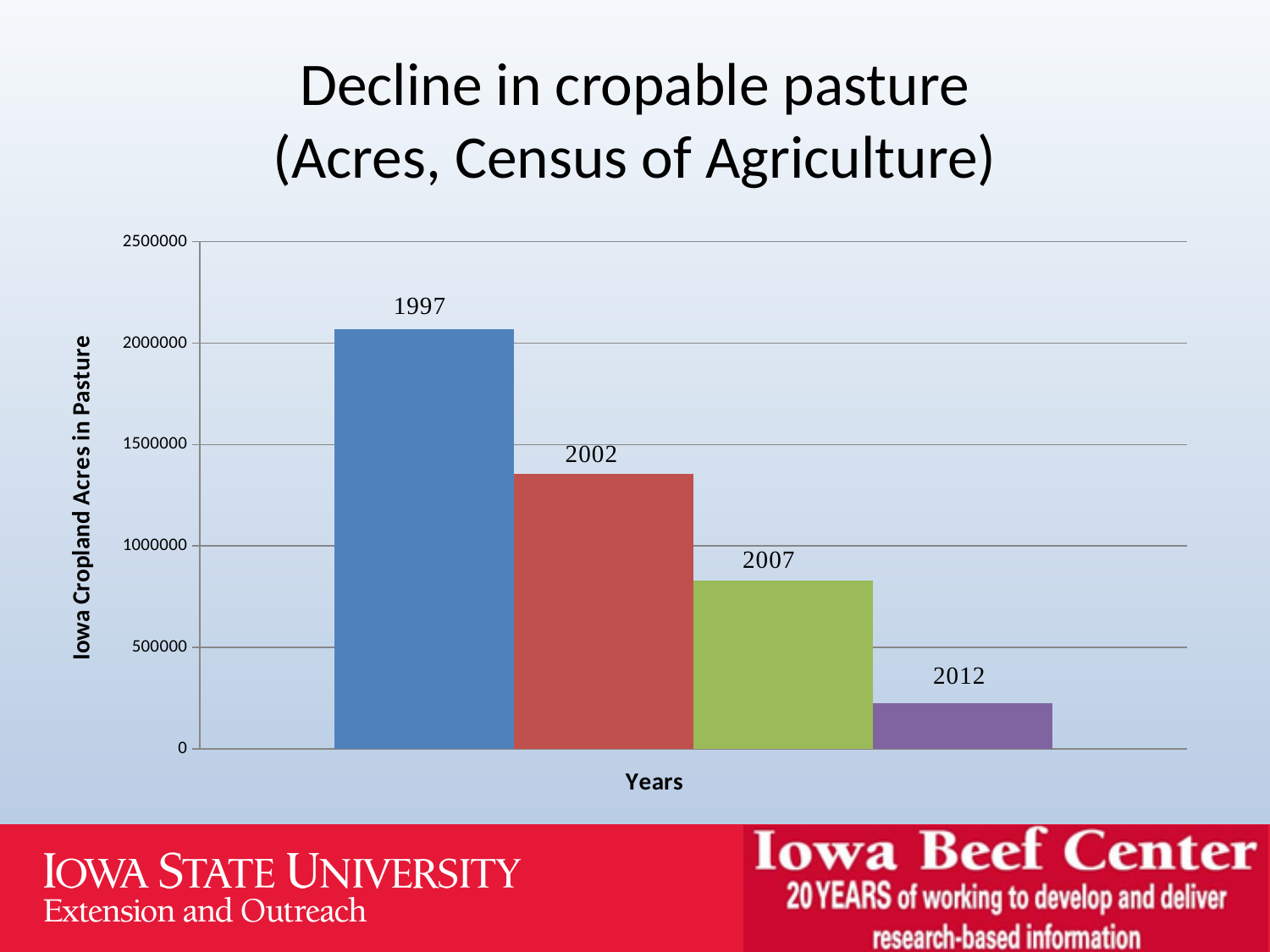
Which year has the lowest value in the chart? 2012 What is the title of the horizontal axis of the chart? Years Which year has the highest value in the chart? 1997 Is the value for 2012 greater or less than 500000? less Is the value for 2002 greater or less than 1500000? less What kind of chart is shown on the slide? bar chart What is the title of the vertical axis of the chart? Iowa Cropland Acres in Pasture Do the values rise or fall from 1997 to 2012 along the x axis? fall How many bars (years) are plotted in the chart? 4 Which is larger, the value for 2002 or the value for 2007? 2002 Is the value for 2007 greater or less than 1000000? less